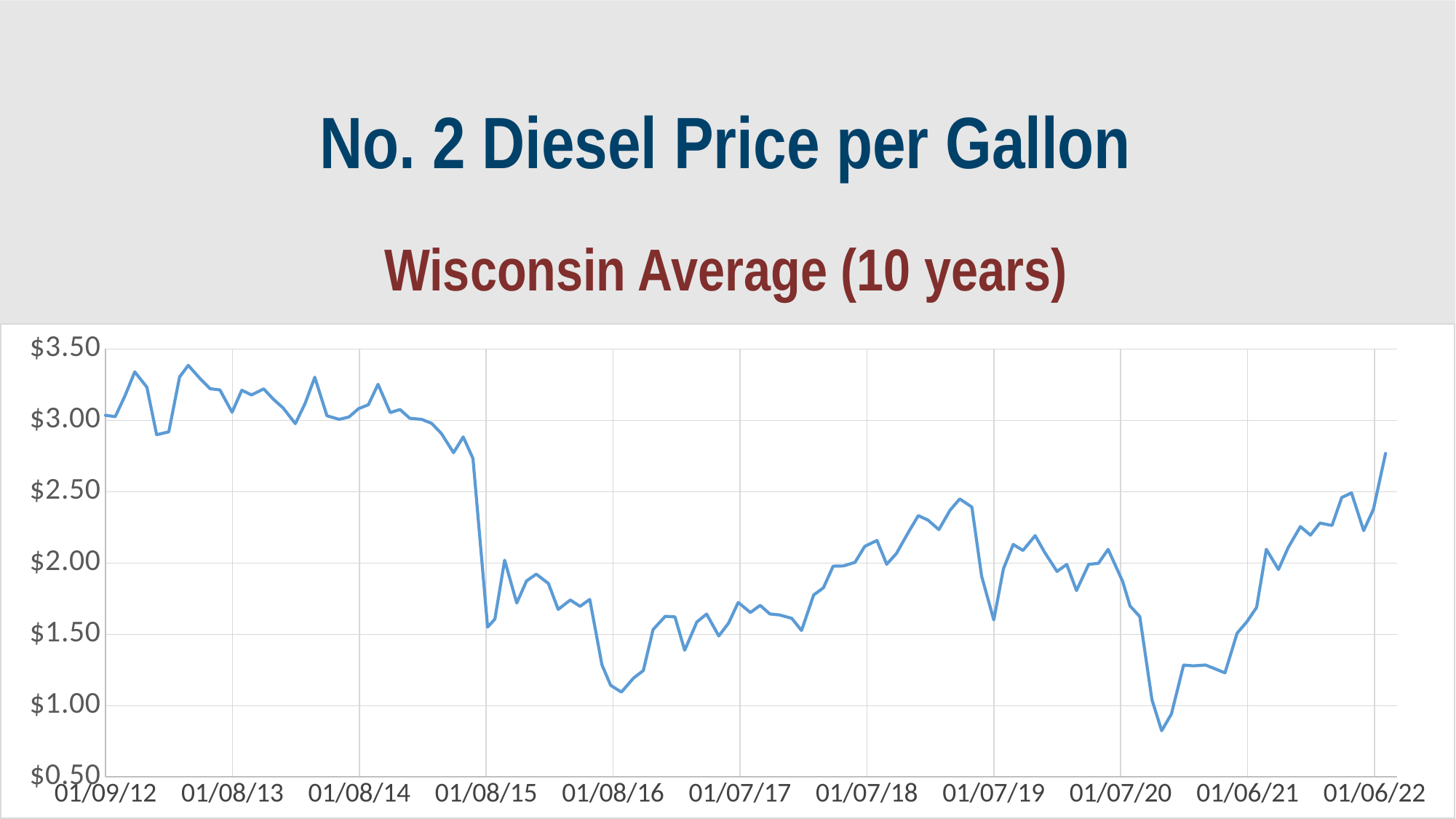
Which date has the higher diesel price, 01/07/20 or 01/06/22? 01/06/22 Is the diesel price at 01/06/21 greater or less than $2.00? less Which date has the higher diesel price, 01/08/13 or 01/08/16? 01/08/13 Is the diesel price at 01/07/19 greater or less than $2.00? less What is the title of the chart on the slide? No. 2 Diesel Price per Gallon Is the diesel price at 01/08/16 greater or less than $1.50? less What kind of chart is shown on the slide? line chart What subtitle appears below the chart title? Wisconsin Average (10 years) Does the diesel price rise or fall between 01/07/20 and 01/06/22? rise How many date labels are shown on the x axis? 11